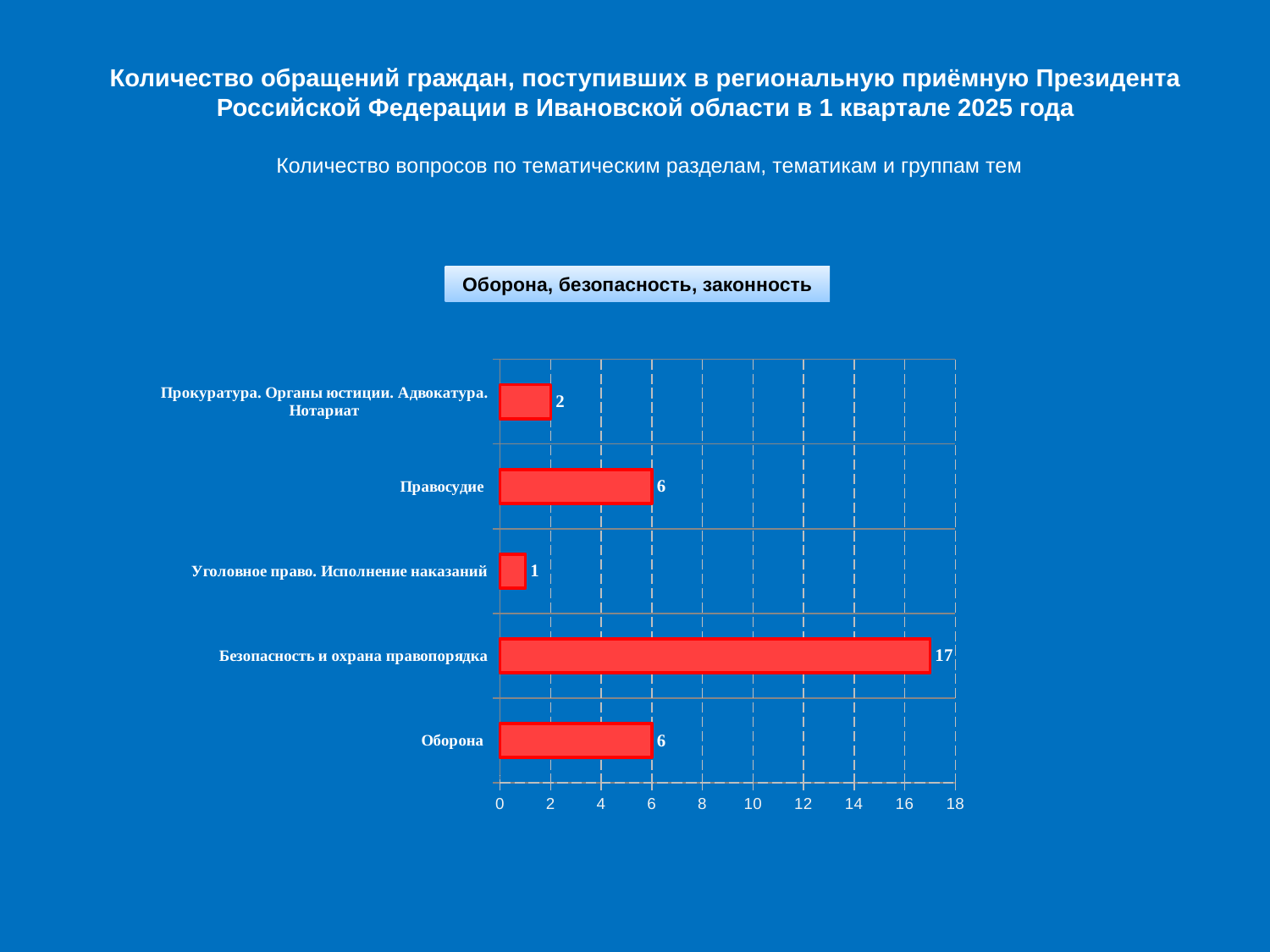
What is the difference between the values for Безопасность и охрана правопорядка and Оборона? 11 What kind of chart is shown on the slide? bar chart Is the value for Безопасность и охрана правопорядка greater or less than 10? greater What is the title shown in the box above the chart? Оборона, безопасность, законность What is the value for Правосудие? 6 How many categories are shown in the chart? 5 Which category has the highest value? Безопасность и охрана правопорядка What is the value for Безопасность и охрана правопорядка? 17 What is the value for Прокуратура. Органы юстиции. Адвокатура. Нотариат? 2 Which is larger, the value for Прокуратура. Органы юстиции. Адвокатура. Нотариат or the value for Правосудие? Правосудие Which category has the lowest value? Уголовное право. Исполнение наказаний What is the value for Уголовное право. Исполнение наказаний? 1